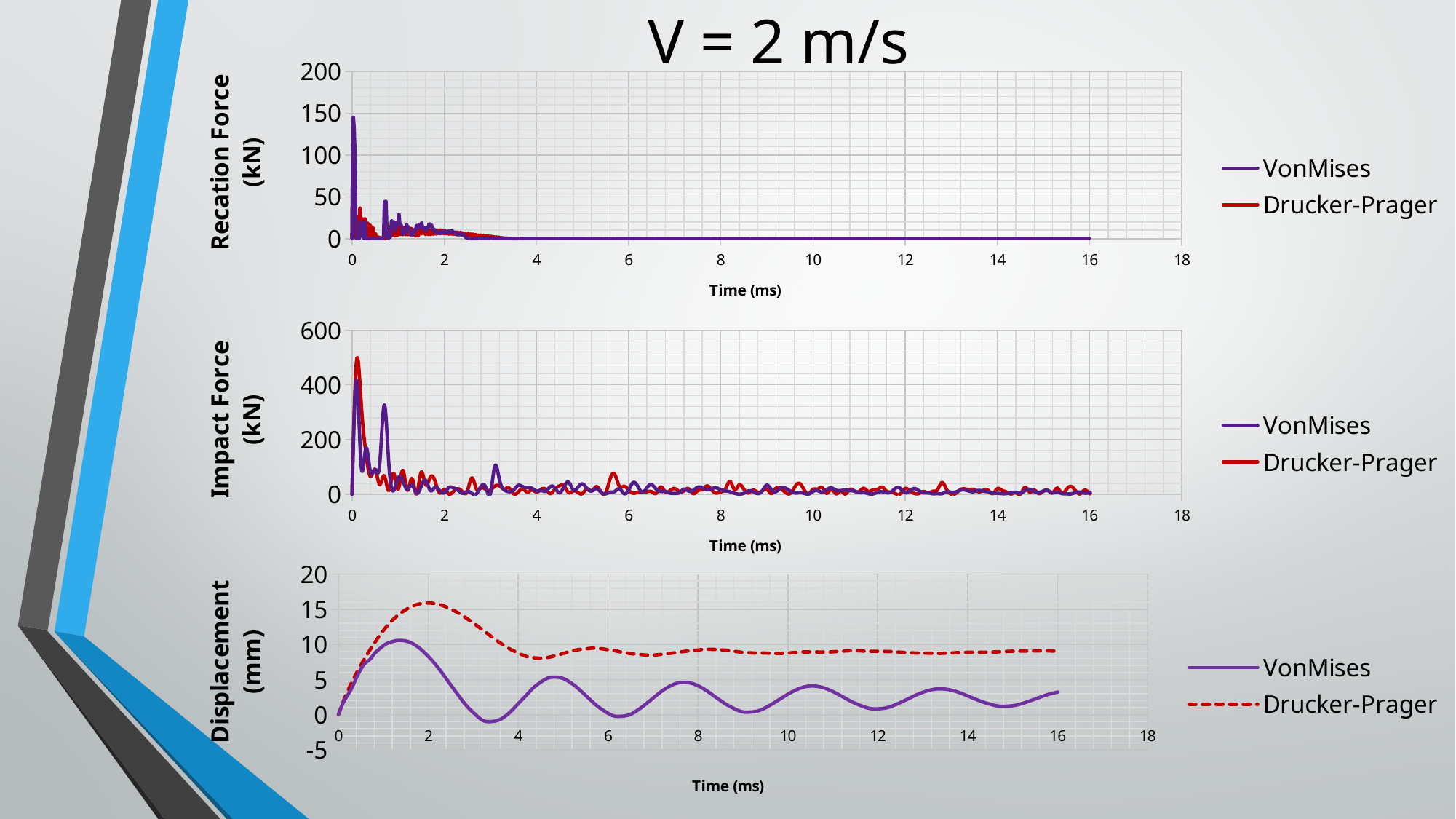
In the Reaction Force chart, do the values generally rise or fall along the x axis after the initial peak? fall How many series does the legend of the Displacement chart list? 2 In the Displacement chart, is the peak value for Drucker-Prager greater or less than 10? greater What is the x-axis label on the Displacement chart? Time (ms) What are the two series named in the legend of the Impact Force chart? VonMises and Drucker-Prager What kind of chart is the top chart (Reaction Force)? line chart In the Impact Force chart, is the peak value for VonMises greater or less than 600? less In the Impact Force chart, is the peak value for Drucker-Prager greater or less than 400? greater In the Displacement chart, which series is higher at 16 ms, VonMises or Drucker-Prager? Drucker-Prager In the Displacement chart, which series has the higher peak, VonMises or Drucker-Prager? Drucker-Prager